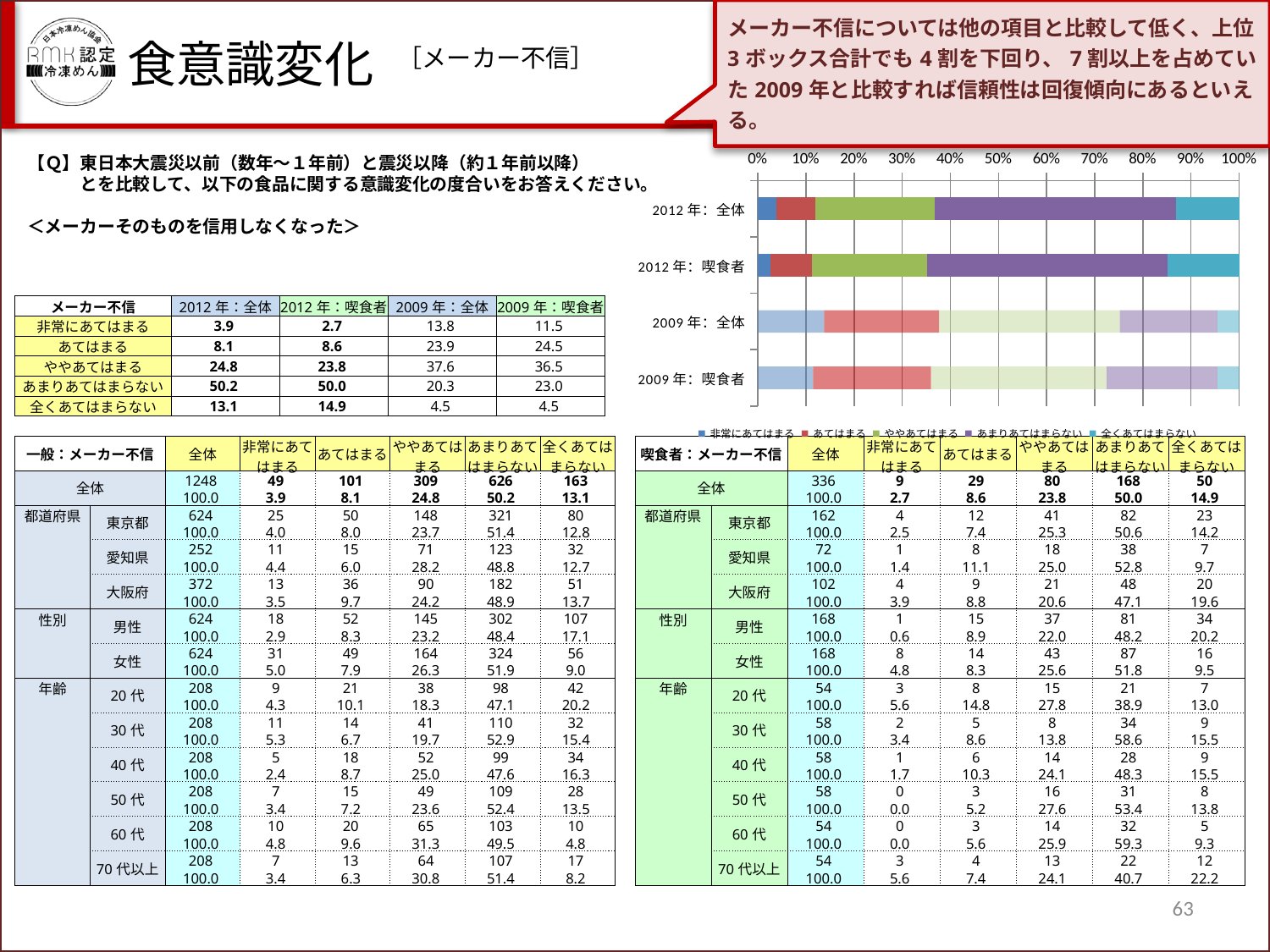
In the chart, is the あまりあてはまらない segment for 2009年: 全体 greater or less than 30%? less What is the maximum value shown on the chart's horizontal axis? 100% In the chart, which bar has the larger ややあてはまる segment: 2012年: 喫食者 or 2009年: 喫食者? 2009年: 喫食者 In the chart, is the 非常にあてはまる segment for 2012年: 喫食者 greater or less than 10%? less How many bars (categories) does the chart on the right show? 4 In the chart, which bar has the larger あまりあてはまらない segment: 2012年: 全体 or 2009年: 全体? 2012年: 全体 In the chart, is the あまりあてはまらない segment for 2012年: 全体 greater or less than 40%? greater In the chart, which bar has the larger 非常にあてはまる segment: 2012年: 全体 or 2009年: 全体? 2009年: 全体 How many series does the legend of the chart list? 5 What kind of chart is shown on the right side of the slide? stacked bar chart Which category is plotted in the top bar of the chart? 2012年: 全体